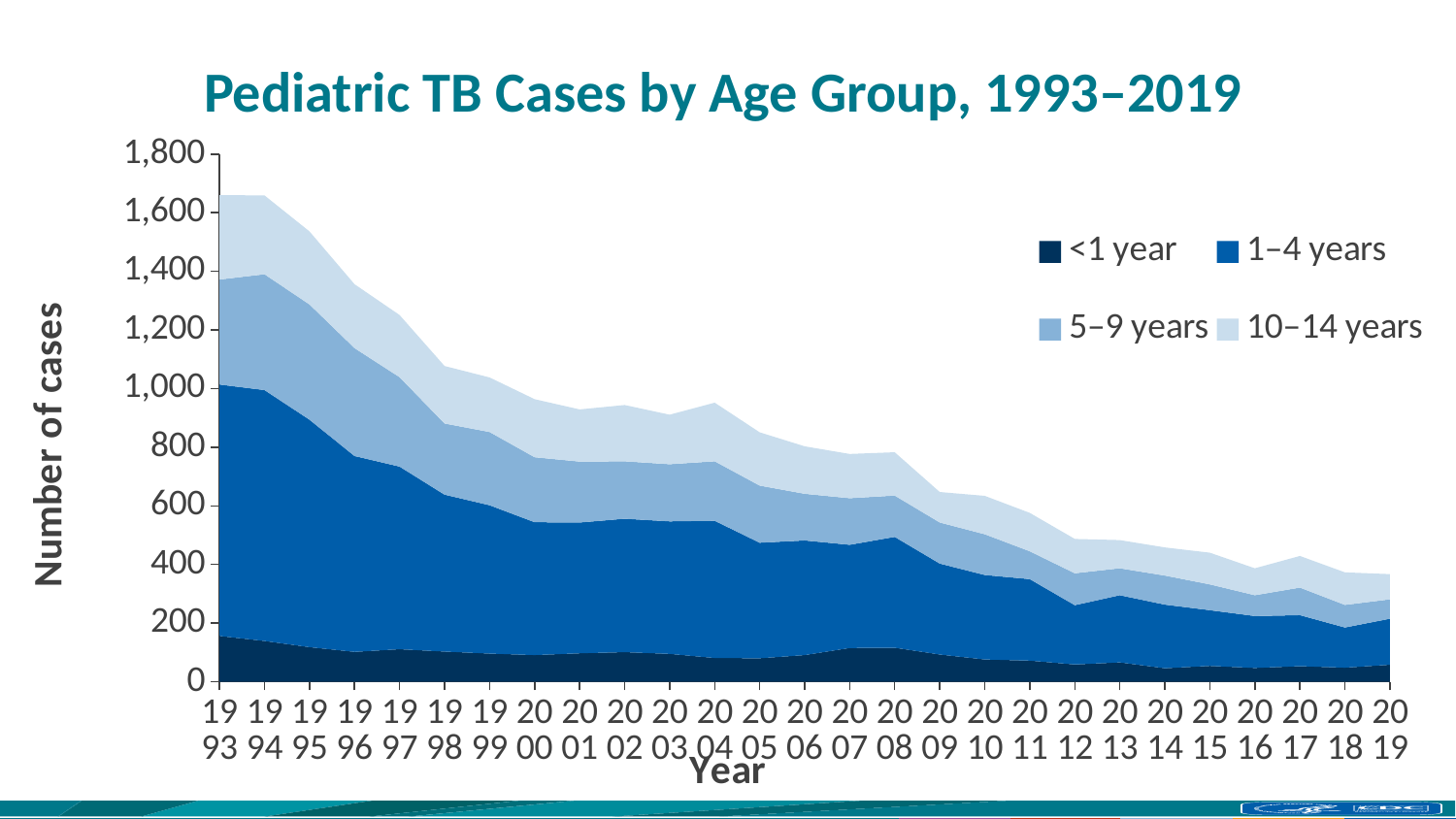
Is the total number of cases in 2019 greater or less than 400? less Is the total number of cases in 2000 greater or less than 1,000? less How many series does the legend list? 4 What is the title of the chart? Pediatric TB Cases by Age Group, 1993–2019 Is the total number of cases in 2008 greater or less than 600? greater Which year has the larger total number of cases, 1993 or 2019? 1993 How many years are plotted along the x axis? 27 Do the total pediatric TB cases rise or fall from 1993 to 2019? Fall What kind of chart is shown on the slide? Stacked area chart Which age group contributes the most cases in 1993? 1–4 years What is the label on the vertical axis? Number of cases